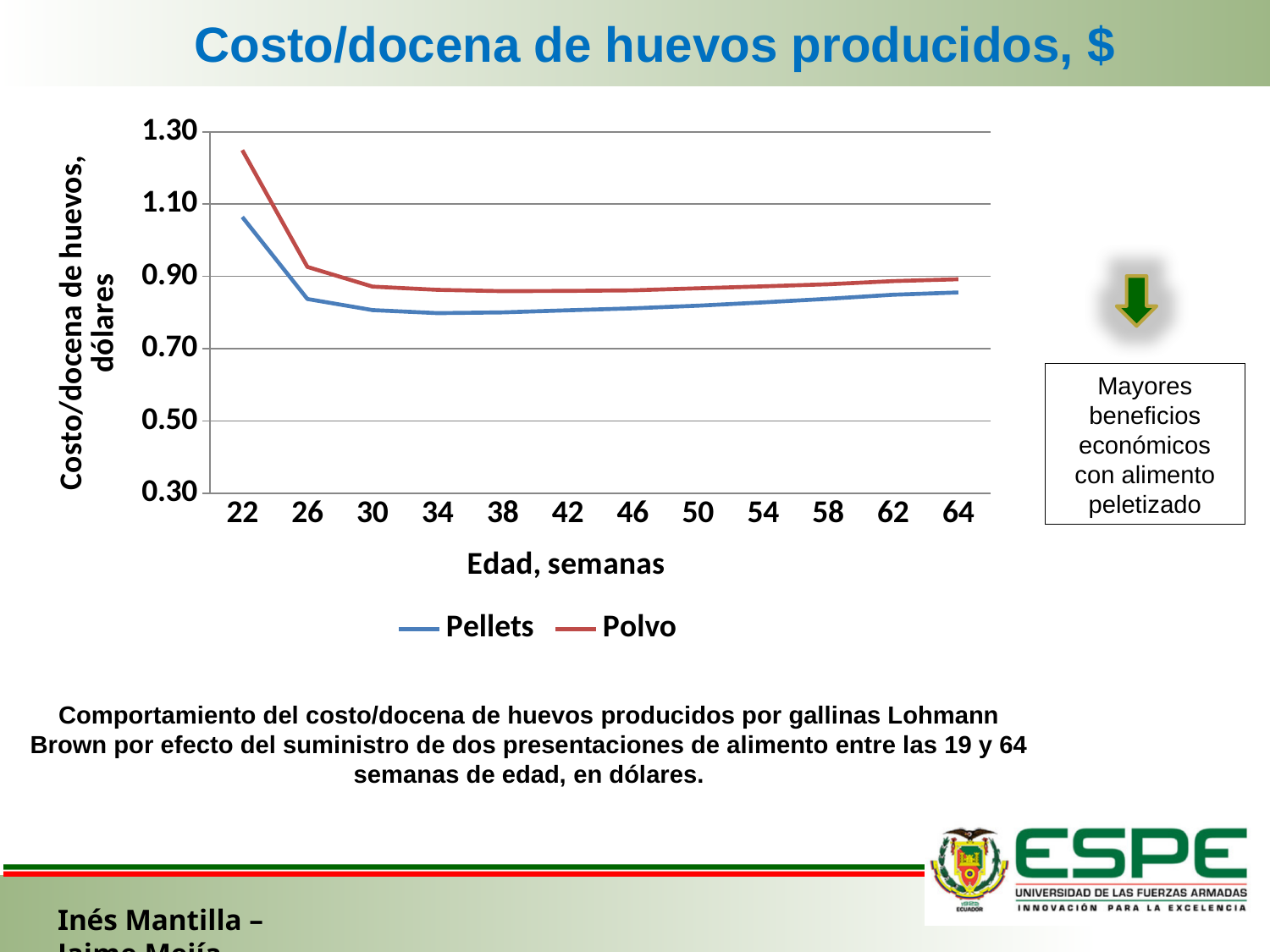
Is the value for Pellets at week 22 greater or less than 1.10? less Do the values for Polvo rise or fall between week 22 and week 30? fall What is the label of the x axis? Edad, semanas Is the value for Polvo at week 22 greater or less than 1.10? greater How many age points (weeks) are labelled on the x axis? 12 Is the value for Pellets at week 22 greater or less than 0.90? greater What kind of chart is shown on the slide? line chart At week 22, which series has the higher cost, Pellets or Polvo? Polvo At which week is the Pellets series at its highest value? 22 What are the two series named in the legend? Pellets and Polvo How many series does the legend list? 2